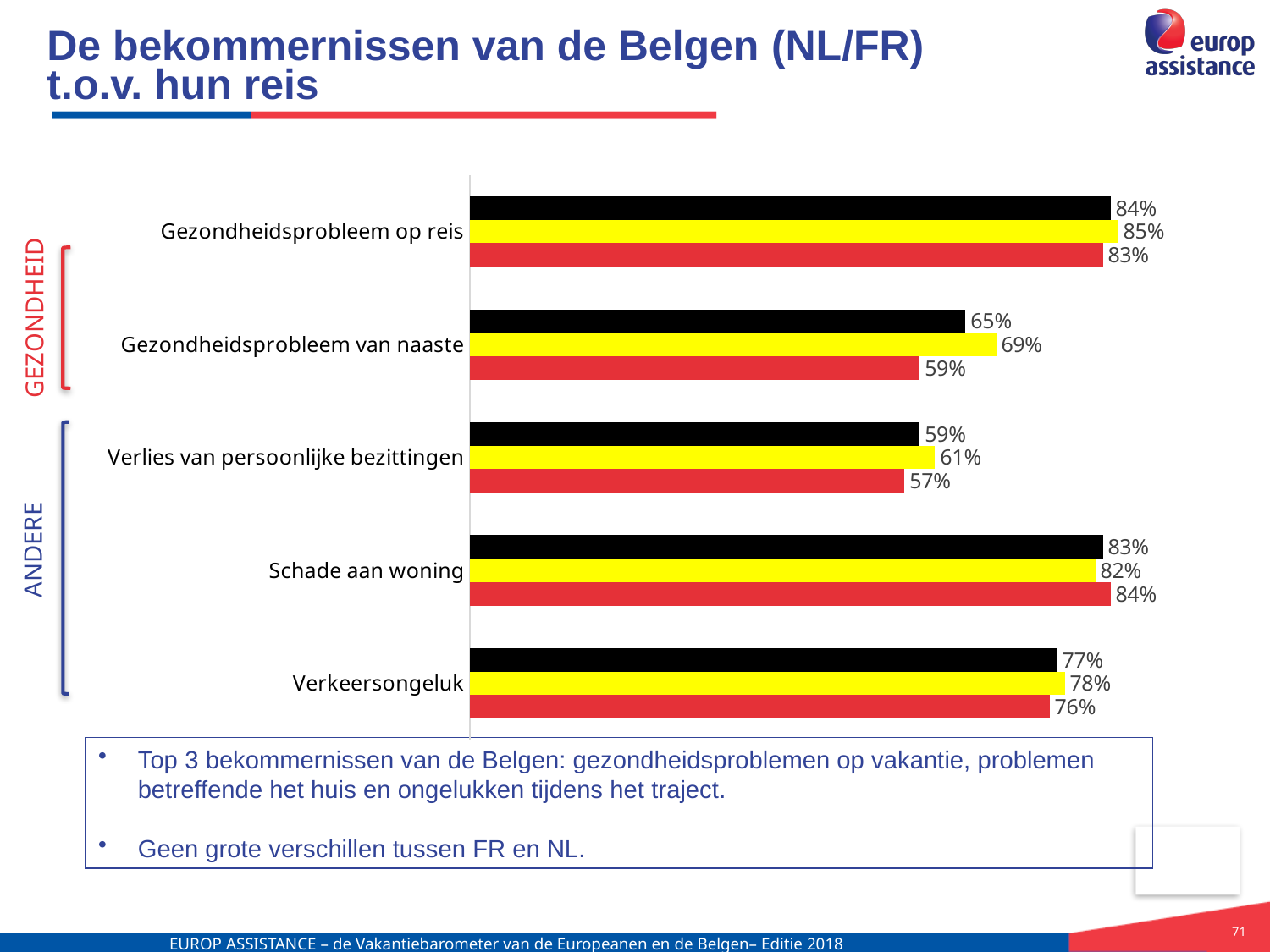
How many categories are shown in the chart? 5 What is the value of the yellow bar for Verkeersongeluk? 78% What is the value of the red bar for Schade aan woning? 84% Which category has the lowest value for the red bars? Verlies van persoonlijke bezittingen Which two categories are grouped under the label GEZONDHEID? Gezondheidsprobleem op reis and Gezondheidsprobleem van naaste Which is larger for Verkeersongeluk: the black bar or the red bar? the black bar What kind of chart is shown on the slide? bar chart What is the value of the red bar for Verlies van persoonlijke bezittingen? 57% What is the value of the black bar for Gezondheidsprobleem op reis? 84% What is the difference between the yellow and red bars for Gezondheidsprobleem van naaste? 10% What is the value of the yellow bar for Gezondheidsprobleem van naaste? 69% Which category has the highest value for the yellow bars? Gezondheidsprobleem op reis